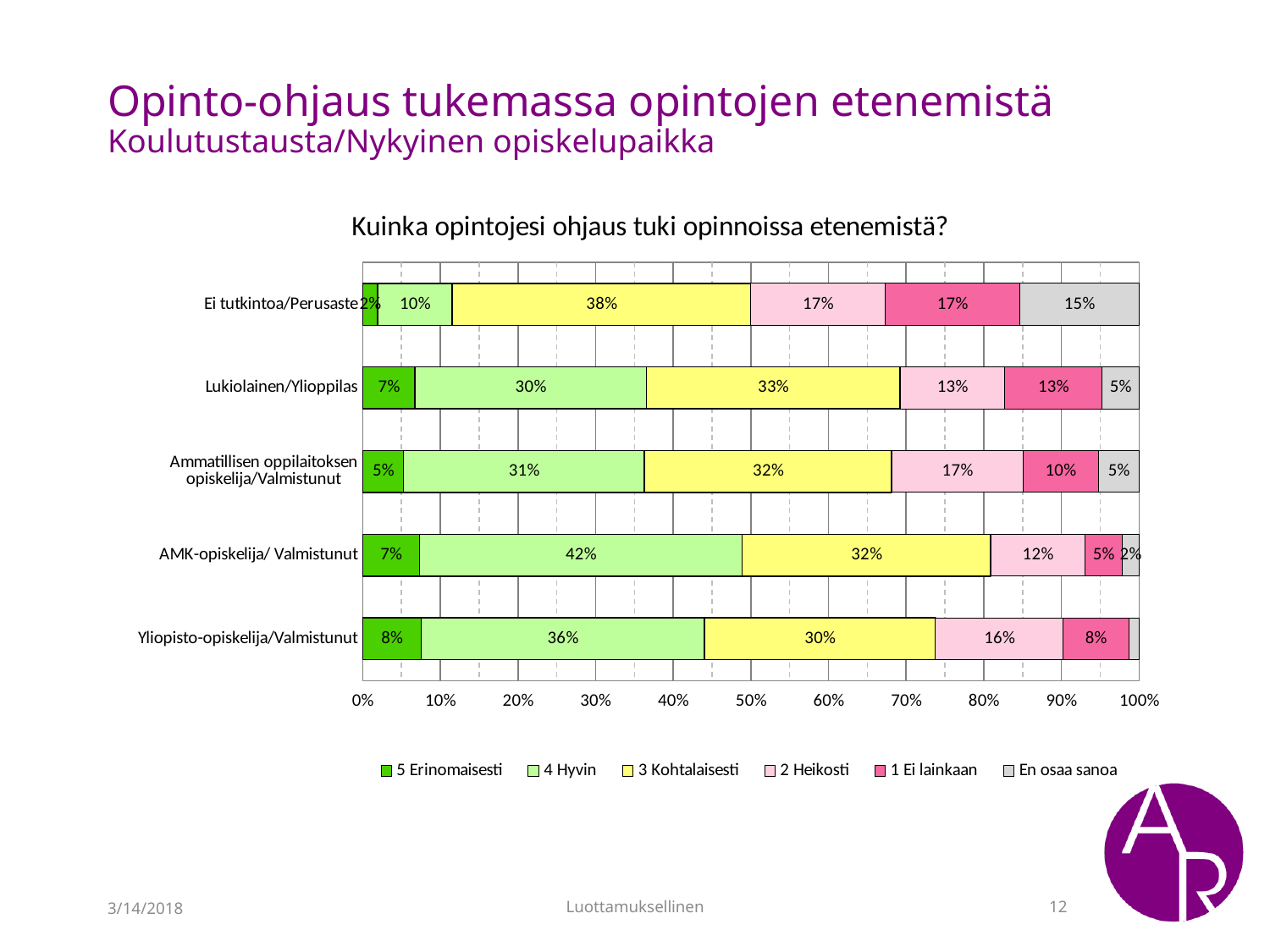
What is the value of "En osaa sanoa" for Ei tutkintoa/Perusaste? 15% How many categories (education backgrounds) are shown on the chart? 5 What is the difference between the "1 Ei lainkaan" values for Ei tutkintoa/Perusaste and AMK-opiskelija/ Valmistunut? 12% Which is larger: the "2 Heikosti" value for Ammatillisen oppilaitoksen opiskelija/Valmistunut or for Lukiolainen/Ylioppilas? Ammatillisen oppilaitoksen opiskelija/Valmistunut What is the value of "4 Hyvin" for AMK-opiskelija/ Valmistunut? 42% What is the title of the chart? Kuinka opintojesi ohjaus tuki opinnoissa etenemistä? What is the value of "5 Erinomaisesti" for Yliopisto-opiskelija/Valmistunut? 8% Which category has the lowest value for "5 Erinomaisesti"? Ei tutkintoa/Perusaste What is the value of "3 Kohtalaisesti" for Ei tutkintoa/Perusaste? 38% How many series does the legend list? 6 Which category has the highest value for "4 Hyvin"? AMK-opiskelija/ Valmistunut What kind of chart is shown on the slide? Stacked bar chart